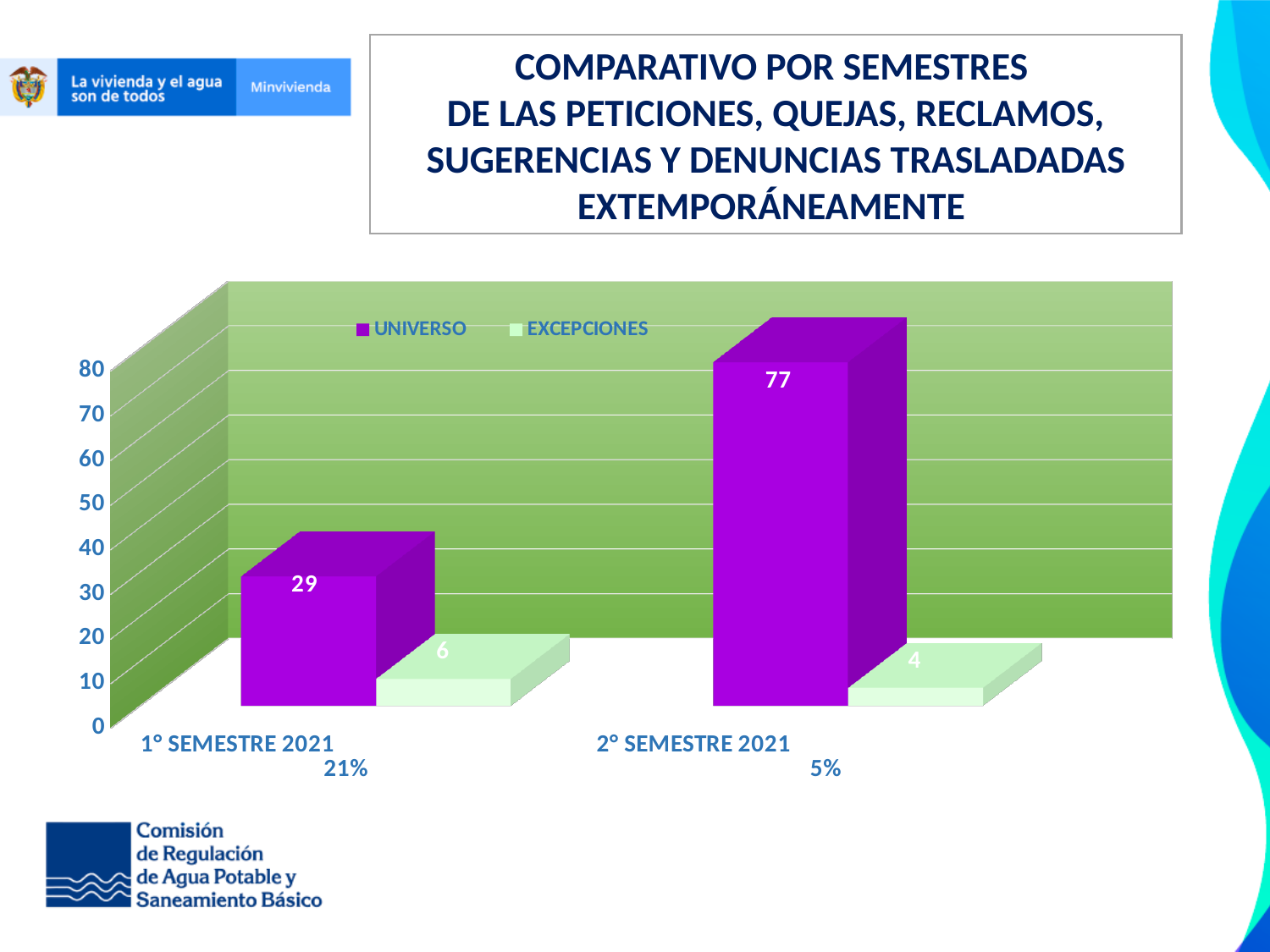
Which semester has the higher UNIVERSO value? 2° SEMESTRE 2021 How many series does the legend list? 2 What is the EXCEPCIONES value for 2° SEMESTRE 2021? 4 What is the EXCEPCIONES value for 1° SEMESTRE 2021? 6 What kind of chart is shown on the slide? bar chart What is the difference between the UNIVERSO values for 2° SEMESTRE 2021 and 1° SEMESTRE 2021? 48 Which semester has the lower EXCEPCIONES value? 2° SEMESTRE 2021 What percentage is printed below the 1° SEMESTRE 2021 category? 21% What is the UNIVERSO value for 1° SEMESTRE 2021? 29 Is the EXCEPCIONES value for 1° SEMESTRE 2021 larger or smaller than the EXCEPCIONES value for 2° SEMESTRE 2021? larger What is the UNIVERSO value for 2° SEMESTRE 2021? 77 How many categories are shown on the x axis? 2